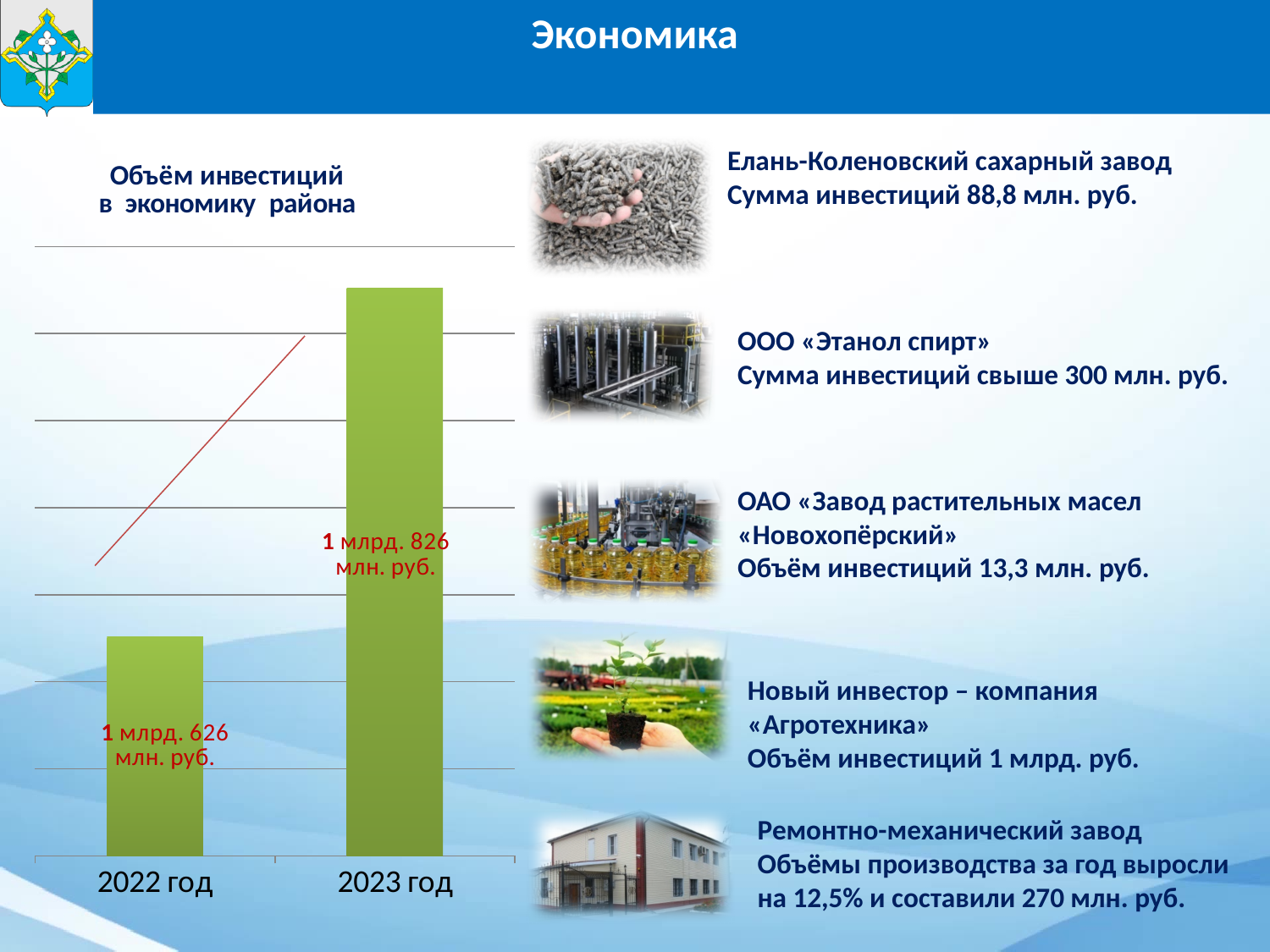
What is the value for 2022 год in the chart 'Объём инвестиций в экономику района'? 1 млрд. 626 млн. руб. Which year has the lowest investment volume in the chart? 2022 год What is the value for 2023 год in the chart 'Объём инвестиций в экономику района'? 1 млрд. 826 млн. руб. Which is larger: the investment volume for 2022 год or for 2023 год? 2023 год Which year has the highest investment volume in the chart? 2023 год By how much does the investment volume for 2023 год exceed that for 2022 год? 200 млн. руб. How many categories (years) are shown in the chart? 2 What colour are the bars in the chart? green Do the values rise or fall from 2022 год to 2023 год? rise What kind of chart is used to show the investment volume? bar chart What is the title of the chart on the slide? Объём инвестиций в экономику района